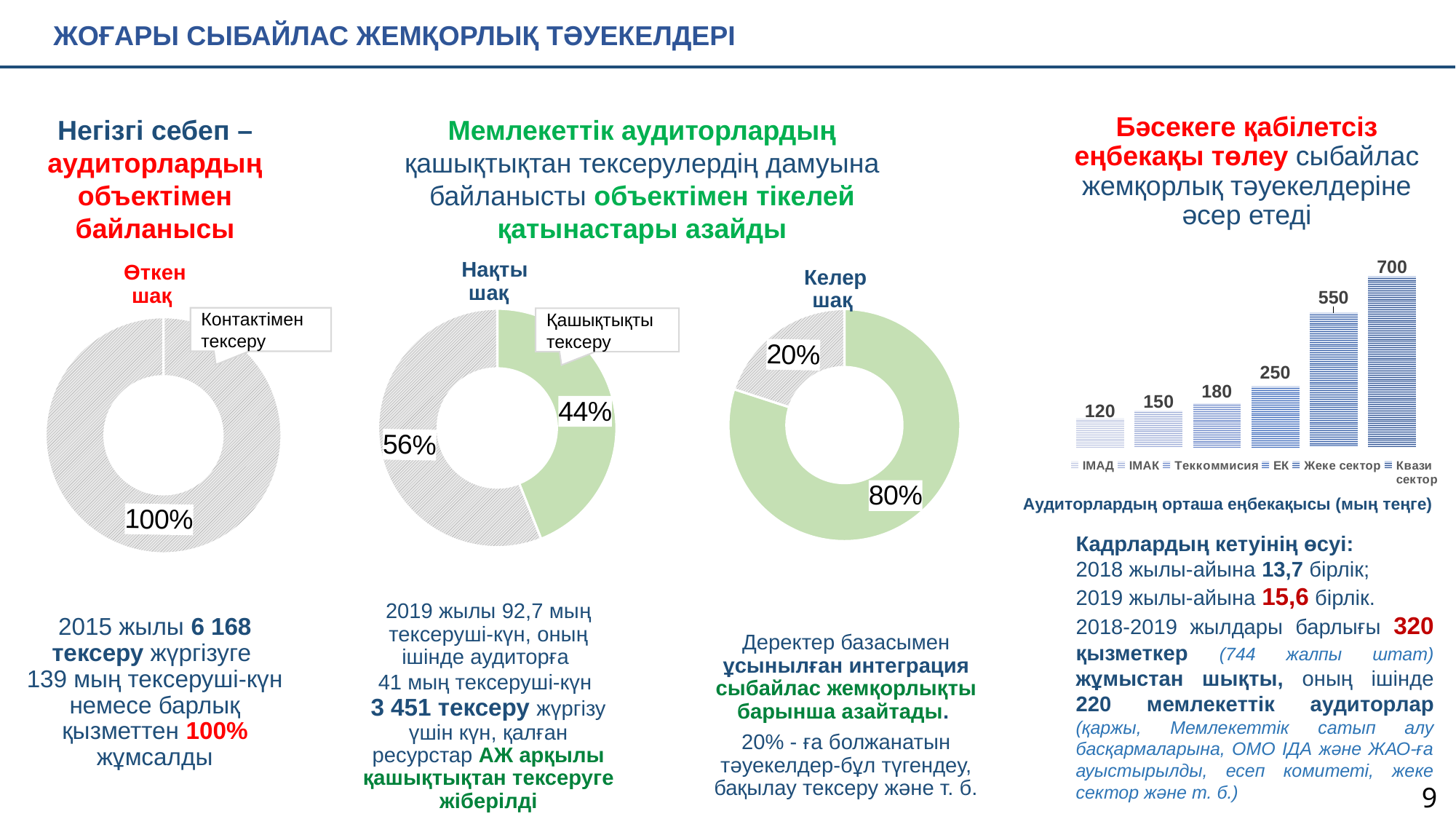
In the bar chart titled 'Аудиторлардың орташа еңбекақысы (мың теңге)', what is the value for Квази сектор? 700 In the bar chart titled 'Аудиторлардың орташа еңбекақысы (мың теңге)', which is larger, ІМАК or ЕК? ЕК How many categories are shown in the bar chart titled 'Аудиторлардың орташа еңбекақысы (мың теңге)'? 6 In the 'Келер шақ' donut chart, what is the value of the larger green slice? 80% Do the values in the bar chart titled 'Аудиторлардың орташа еңбекақысы (мың теңге)' rise or fall from left to right? rise What kind of chart is the 'Нақты шақ' chart in the middle of the slide? donut chart In the bar chart titled 'Аудиторлардың орташа еңбекақысы (мың теңге)', what is the value for ЕК? 250 In the 'Нақты шақ' donut chart, what share is labelled for Қашықтықты тексеру (the green slice)? 44% In the bar chart titled 'Аудиторлардың орташа еңбекақысы (мың теңге)', which category has the lowest value? ІМАД In the bar chart titled 'Аудиторлардың орташа еңбекақысы (мың теңге)', what is the difference between Жеке сектор and Теккоммисия? 370 In the bar chart titled 'Аудиторлардың орташа еңбекақысы (мың теңге)', which category has the highest value? Квази сектор In the 'Өткен шақ' donut chart, what share is shown for Контактімен тексеру? 100%